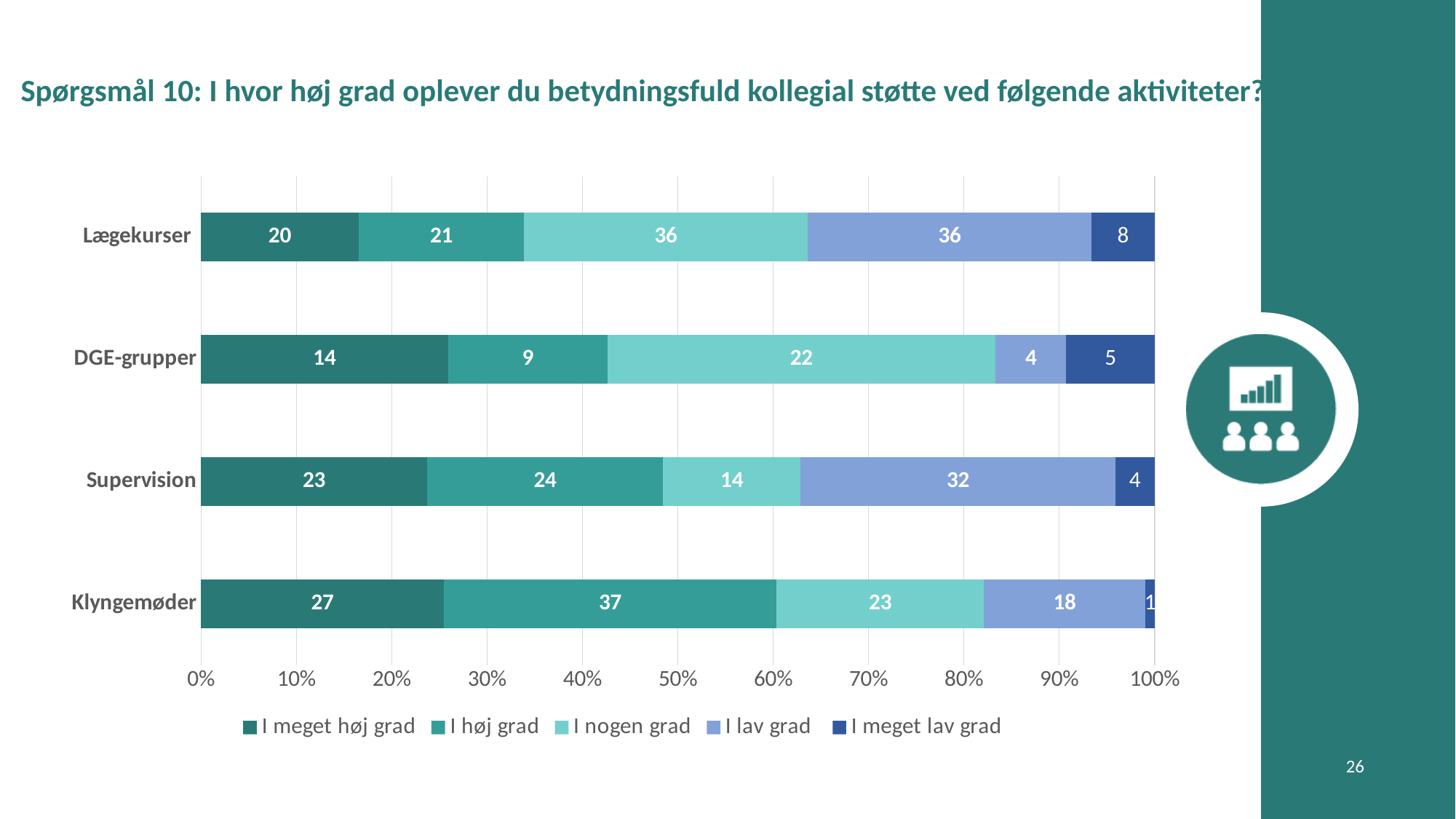
What is the total of all segments in the DGE-grupper bar? 54 What is the value for 'I meget høj grad' for Klyngemøder? 27 How many series does the legend list? 5 What kind of chart is shown on the slide? Stacked bar chart Which category has the highest value for 'I høj grad'? Klyngemøder What is the difference between the 'I lav grad' values for Lægekurser and Klyngemøder? 18 Which is larger: the 'I meget høj grad' value for Supervision or for DGE-grupper? Supervision What is the value for 'I meget lav grad' for DGE-grupper? 5 How many categories are shown on the y axis? 4 Which category has the lowest value for 'I meget lav grad'? Klyngemøder What is the value for 'I lav grad' for Supervision? 32 What is the value for 'I nogen grad' for Lægekurser? 36